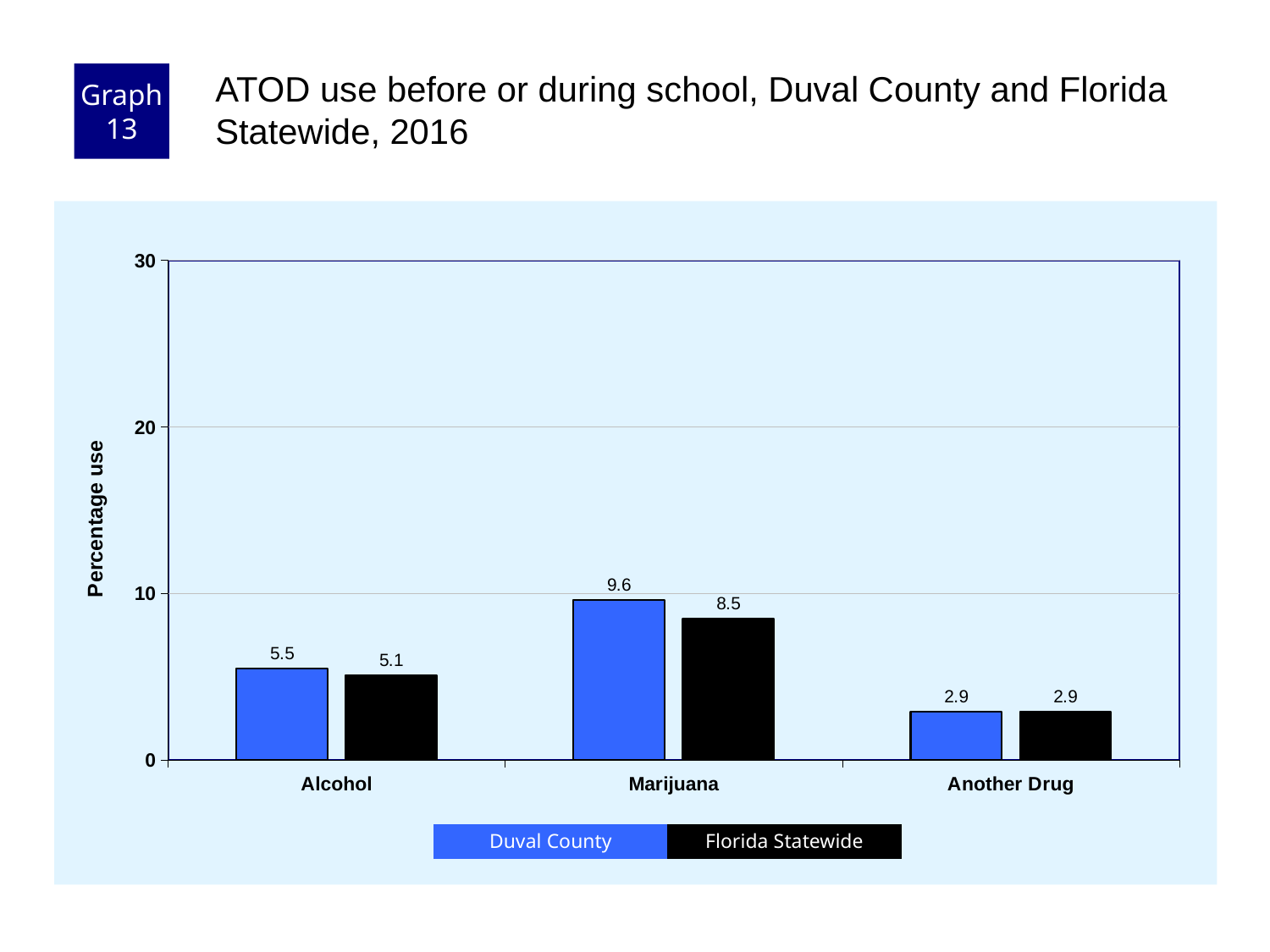
What is the Duval County value for Marijuana? 9.6 What is the Duval County value for Another Drug? 2.9 Which category has the highest Duval County value? Marijuana What is the Florida Statewide value for Alcohol? 5.1 Which is larger for Alcohol, the Duval County value or the Florida Statewide value? Duval County How many categories are shown on the x axis? 3 What kind of chart is shown on the slide? bar chart What is the difference between the Duval County values for Marijuana and Alcohol? 4.1 Which category has the lowest Florida Statewide value? Another Drug Is the Florida Statewide value for Marijuana greater or less than 10? less What is the difference between the Duval County and Florida Statewide values for Marijuana? 1.1 How many series does the legend list? 2